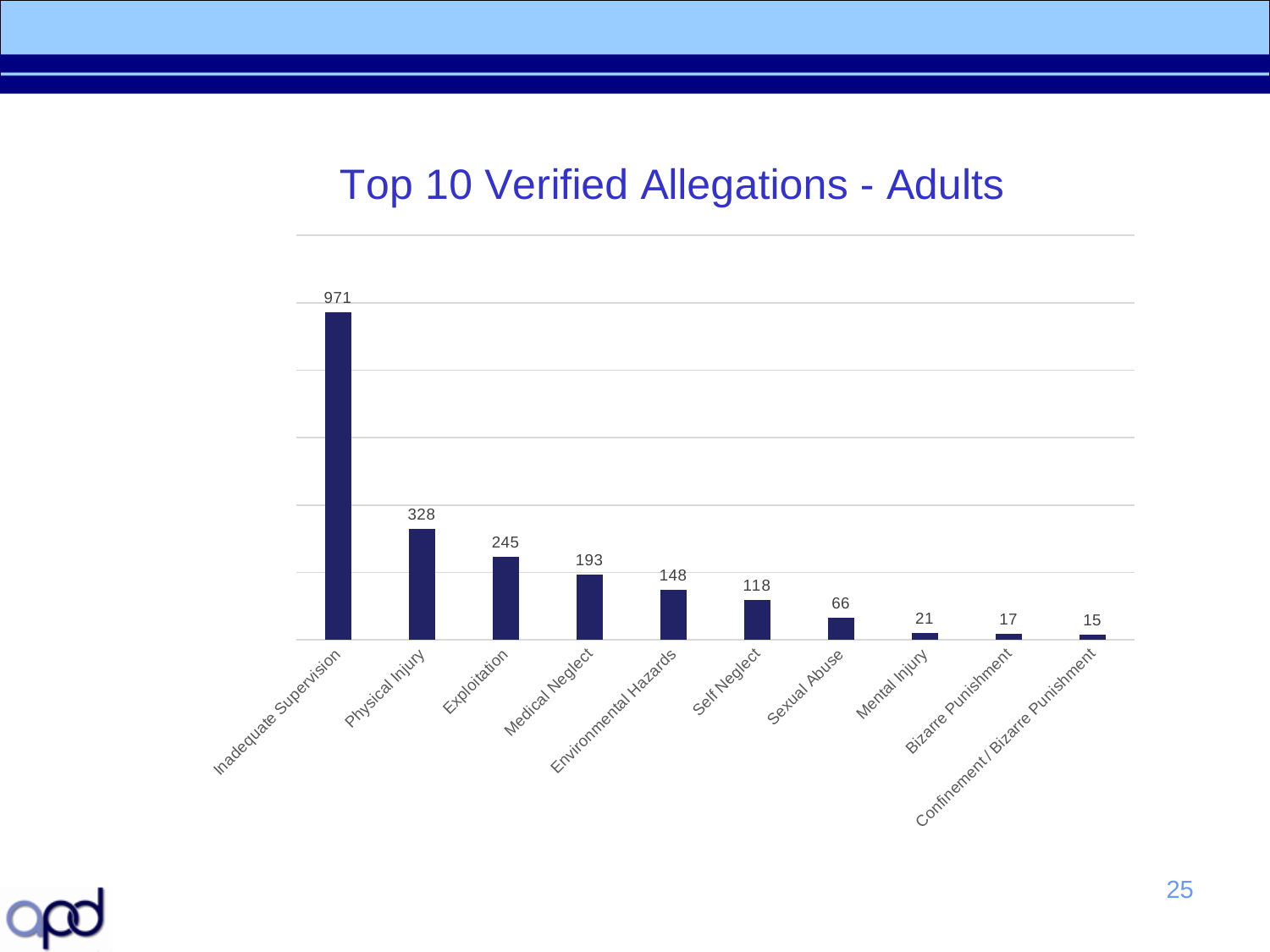
How many categories are shown in the chart? 10 Which is larger, Environmental Hazards or Self Neglect? Environmental Hazards What is the title of the chart? Top 10 Verified Allegations - Adults What is the value for Sexual Abuse? 66 Which category has the lowest value? Confinement / Bizarre Punishment Which category has the highest value? Inadequate Supervision What is the difference between Mental Injury and Bizarre Punishment? 4 What kind of chart is this? Bar chart What is the value for Medical Neglect? 193 Do the values rise or fall from left to right along the x axis? Fall What is the value for Inadequate Supervision? 971 What is the difference between Physical Injury and Exploitation? 83